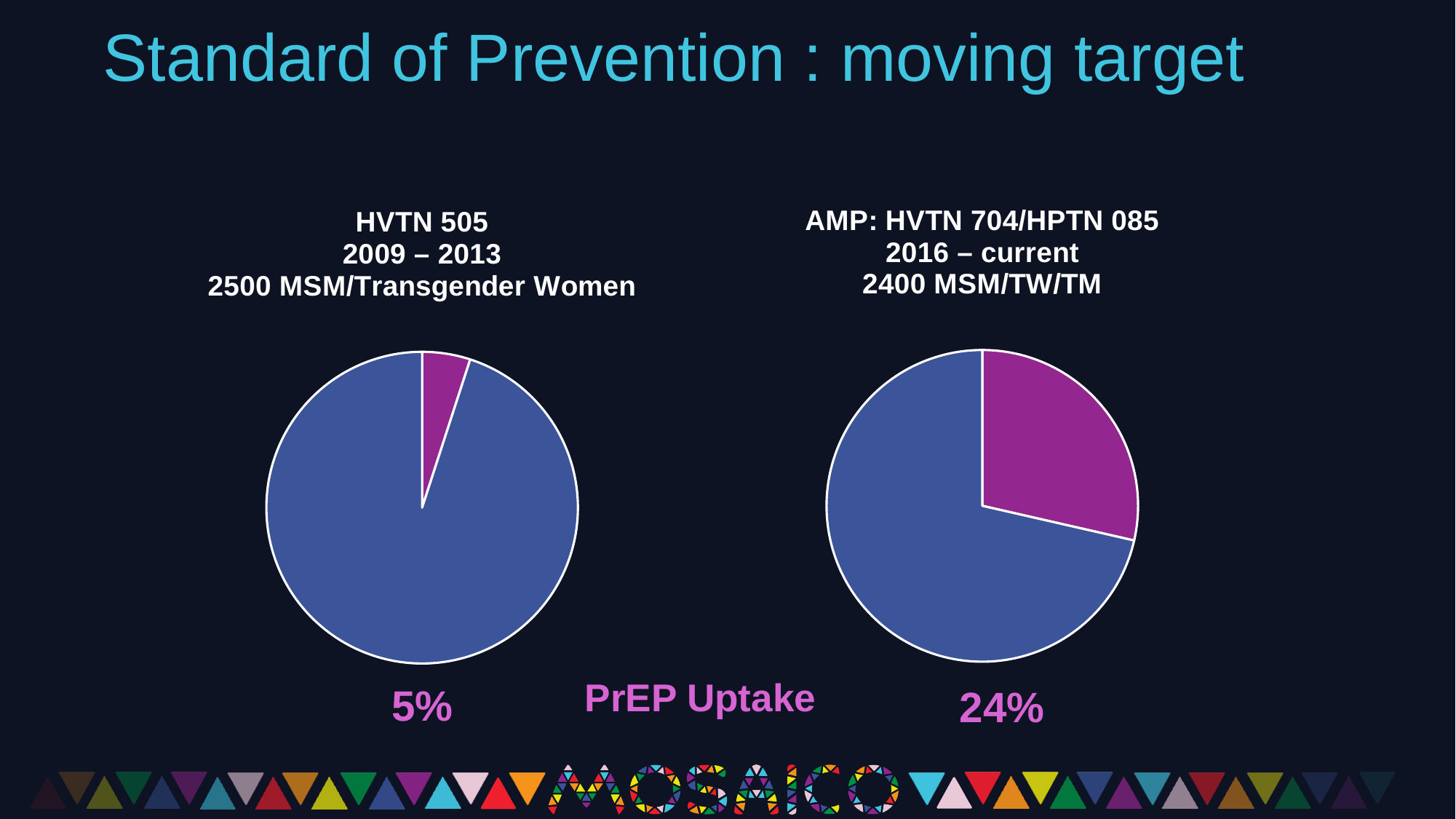
Which pie chart shows the lowest PrEP uptake? HVTN 505 What is the title of the slide containing the pie charts? Standard of Prevention : moving target In the HVTN 505 pie chart, what share of the pie is the purple slice? 5% What is the difference in PrEP uptake between the AMP: HVTN 704/HPTN 085 chart and the HVTN 505 chart? 19% How many pie charts are on the slide? 2 What kind of charts are shown on the slide? Pie charts In the AMP: HVTN 704/HPTN 085 pie chart, what is the PrEP uptake percentage shown? 24% Which study's pie chart shows the higher PrEP uptake, HVTN 505 or AMP: HVTN 704/HPTN 085? AMP: HVTN 704/HPTN 085 What label appears between the two pie charts below them? PrEP Uptake How many slices does each pie chart have? 2 In the HVTN 505 pie chart, what is the PrEP uptake percentage shown? 5%